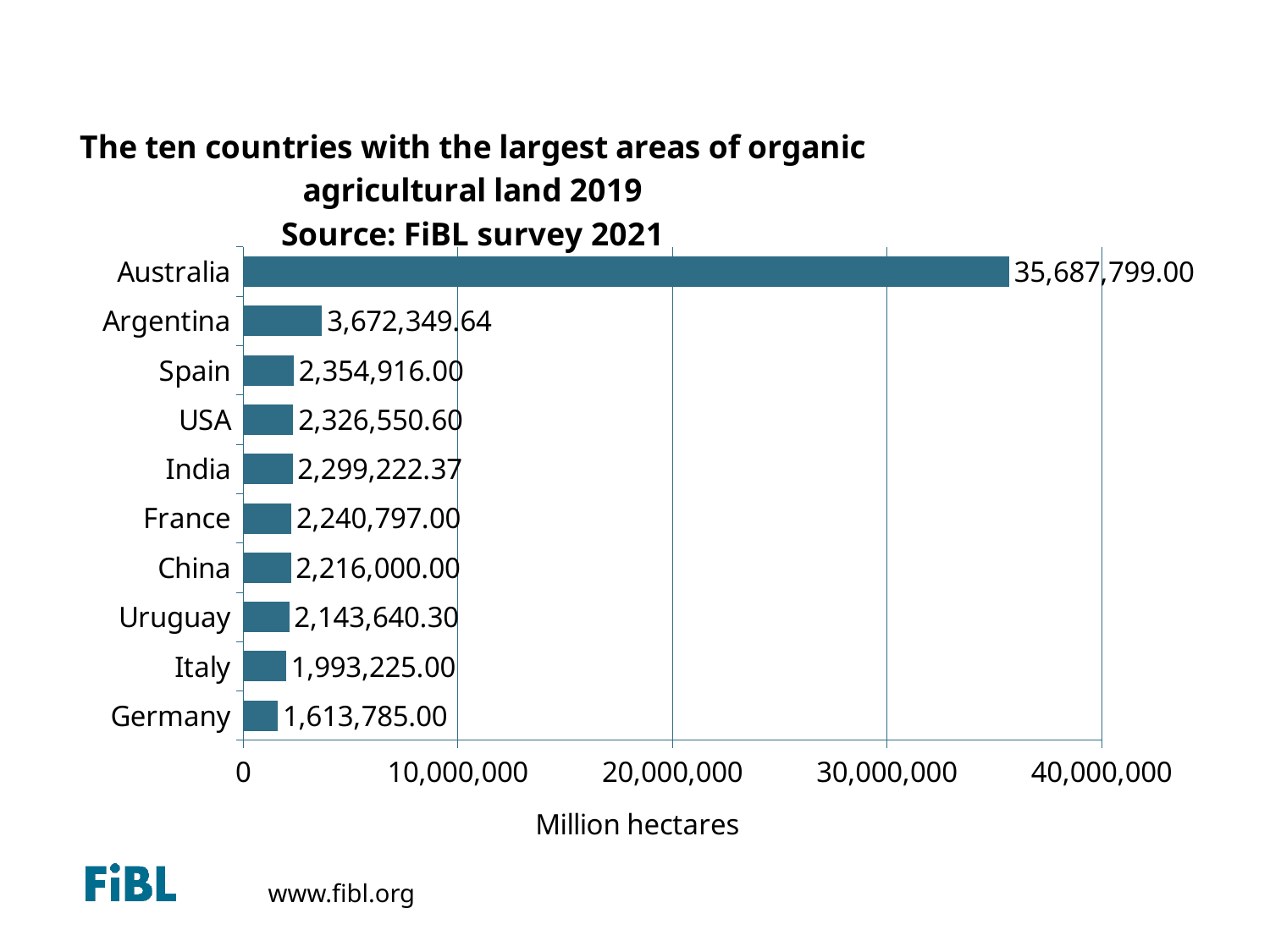
What is the value for Germany? 1,613,785.00 Which is larger, the value for Spain or the value for Italy? Spain Which country has the smallest value on the chart? Germany What is the difference between the values for Australia and Argentina? 32,015,449.36 What is the difference between the values for Italy and Germany? 379,440.00 What is the value for Argentina? 3,672,349.64 How many countries are shown on the chart? 10 Is the value for Australia greater or less than 30,000,000? greater What is the value for Uruguay? 2,143,640.30 What kind of chart is shown on the slide? bar chart What is the value for Australia? 35,687,799.00 Which country has the largest area of organic agricultural land? Australia